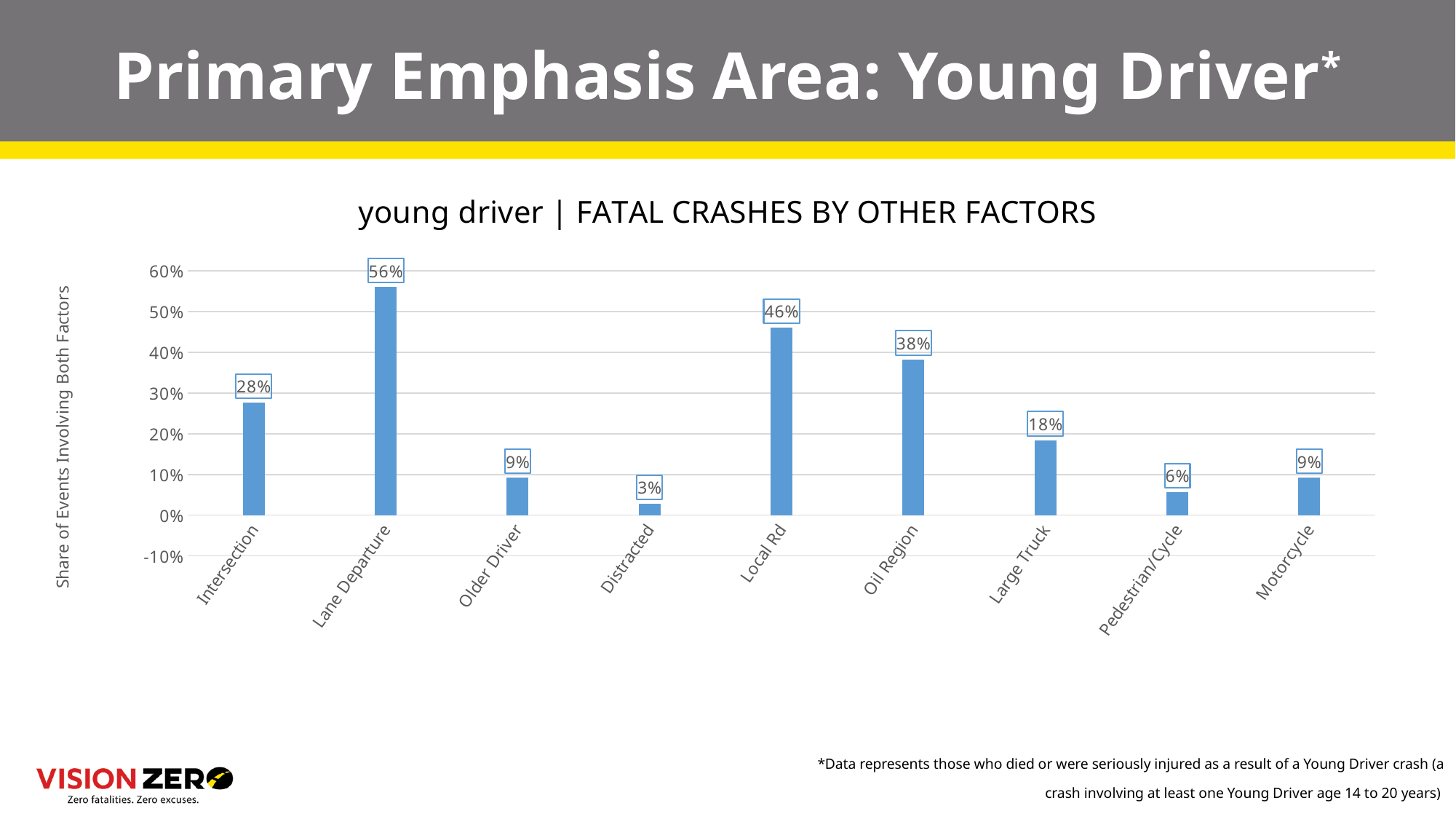
What is the difference between the values for Local Rd and Oil Region? 8% Is the value for Oil Region greater or less than 30%? greater What kind of chart is shown? Bar chart Which category has the highest value? Lane Departure What is the title of the chart? young driver | FATAL CRASHES BY OTHER FACTORS Which is larger, the value for Intersection or the value for Large Truck? Intersection Which category has the lowest value? Distracted How many categories are shown on the x axis? 9 What is the value for Pedestrian/Cycle? 6% What is the value for Local Rd? 46% What is the label on the vertical axis? Share of Events Involving Both Factors What is the value for Lane Departure? 56%